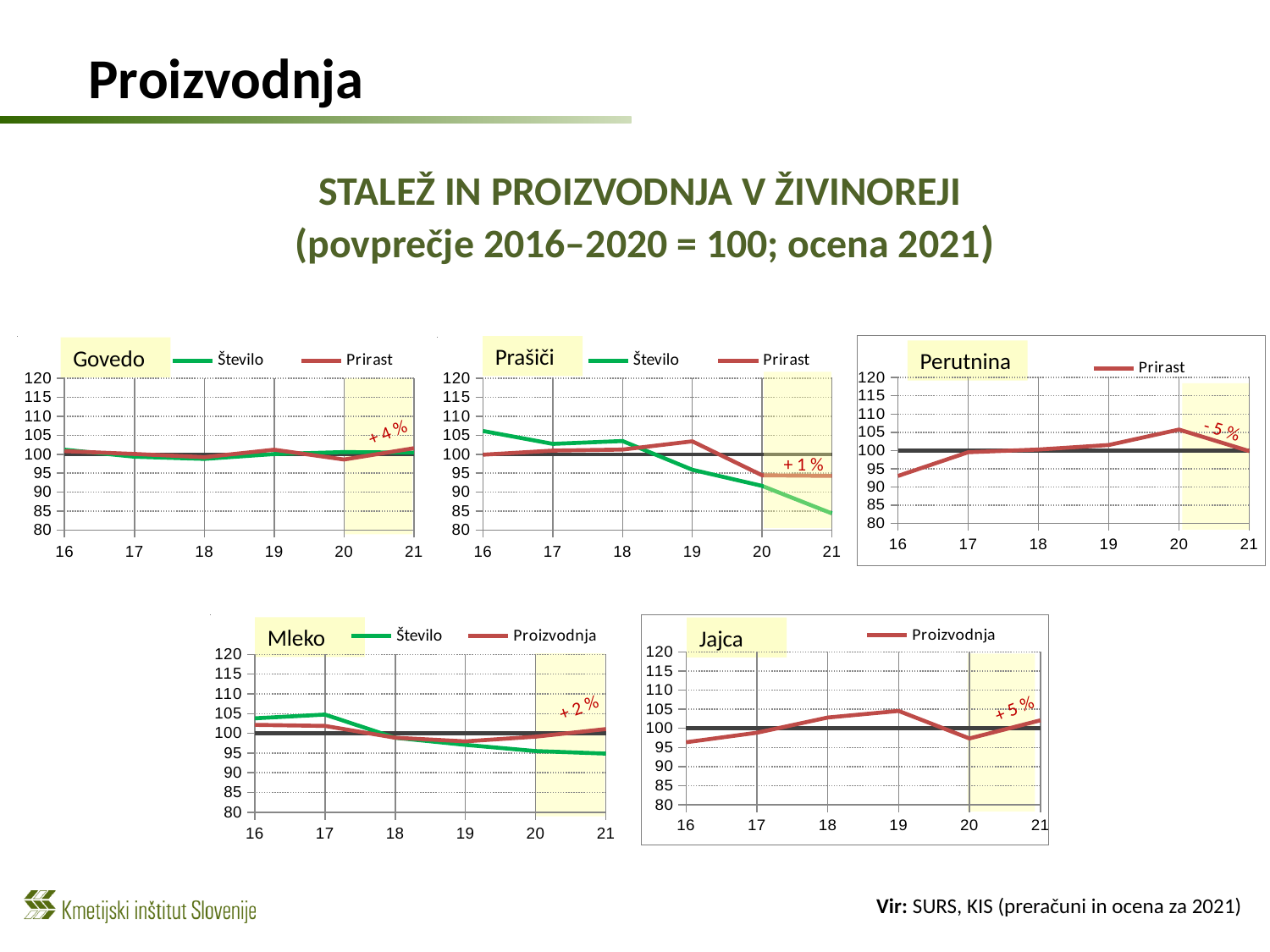
How many years are shown on the x axis of the Jajca chart? 6 In the Mleko chart, in which year is the Število series lowest? 21 In the Prašiči chart, in which year is the Število series highest? 16 How many series does the legend of the Perutnina chart list? 1 What kind of chart is the Govedo chart? line chart In the Mleko chart, is the value of Število at 16 greater or less than 100? greater In the Prašiči chart, does the Število series rise or fall from 16 to 21? fall How many series does the legend of the Govedo chart list? 2 In the Jajca chart, is the value of Proizvodnja at 19 greater or less than 100? greater In the Prašiči chart, is the value of Število at 21 greater or less than 90? less What percentage change is annotated in the shaded 2021 area of the Perutnina chart? - 5 %